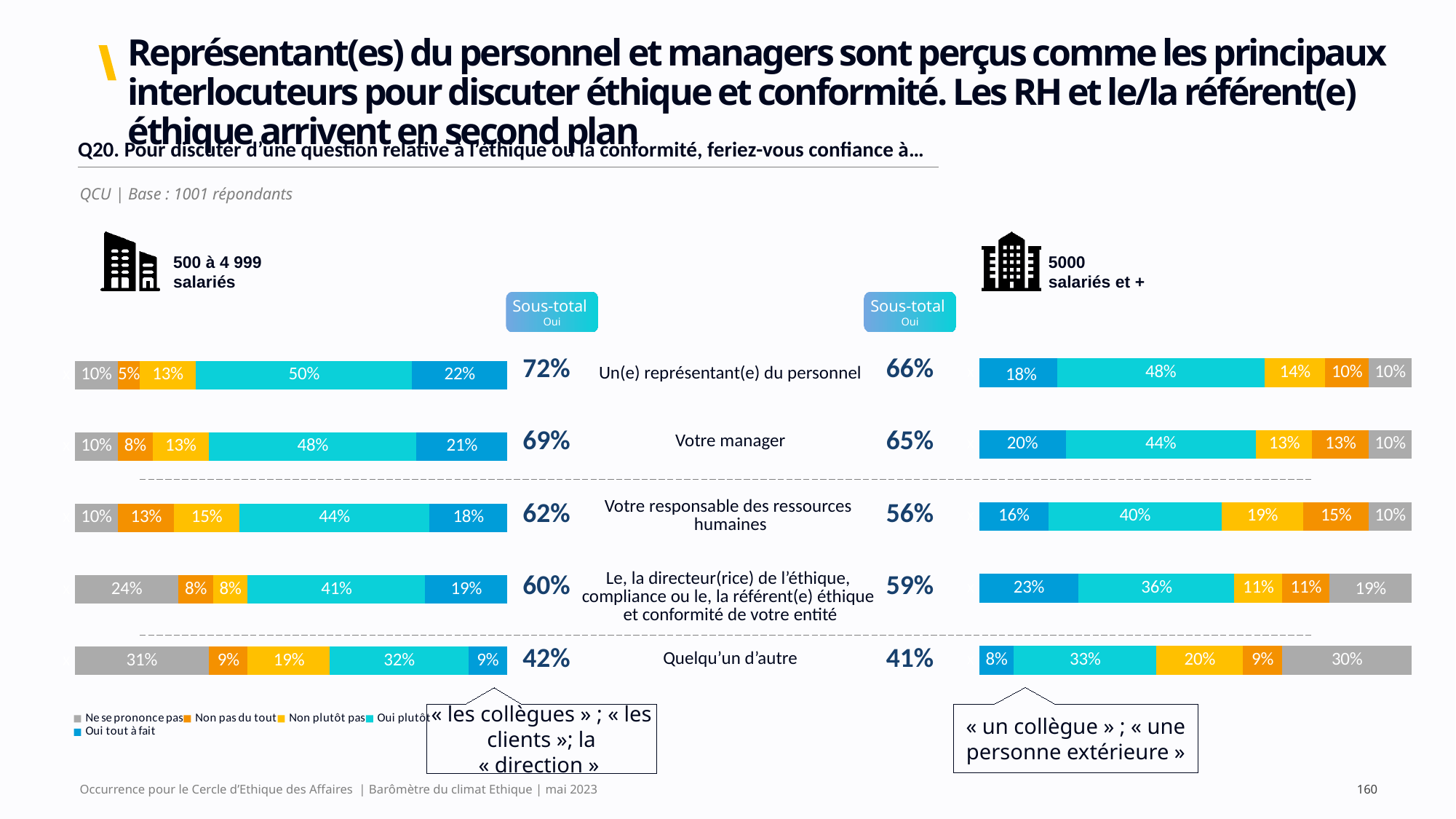
How many categories are shown in the left chart (500 à 4 999 salariés)? 5 What kind of chart is used on this slide? Stacked bar chart In the left chart (500 à 4 999 salariés), what is the 'Oui plutôt' value for 'Un(e) représentant(e) du personnel'? 50% What is the difference between the 'Sous-total Oui' for 'Votre responsable des ressources humaines' in the left chart (500 à 4 999 salariés) and in the right chart (5000 salariés et +)? 6 points In the right chart (5000 salariés et +), what is the 'Oui tout à fait' value for 'Le, la directeur(rice) de l'éthique, compliance ou le, la référent(e) éthique et conformité de votre entité'? 23% In the left chart (500 à 4 999 salariés), what is the 'Ne se prononce pas' value for 'Quelqu'un d'autre'? 31% How many series does the legend list for the charts? 5 In the right chart (5000 salariés et +), is the 'Oui plutôt' value larger for 'Votre manager' or for 'Votre responsable des ressources humaines'? Votre manager In the left chart (500 à 4 999 salariés), which category has the highest 'Sous-total Oui'? Un(e) représentant(e) du personnel In the right chart (5000 salariés et +), what is the 'Non plutôt pas' value for 'Quelqu'un d'autre'? 20% In the right chart (5000 salariés et +), which category has the lowest 'Sous-total Oui'? Quelqu'un d'autre In the left chart (500 à 4 999 salariés), what is the 'Sous-total Oui' for 'Votre manager'? 69%